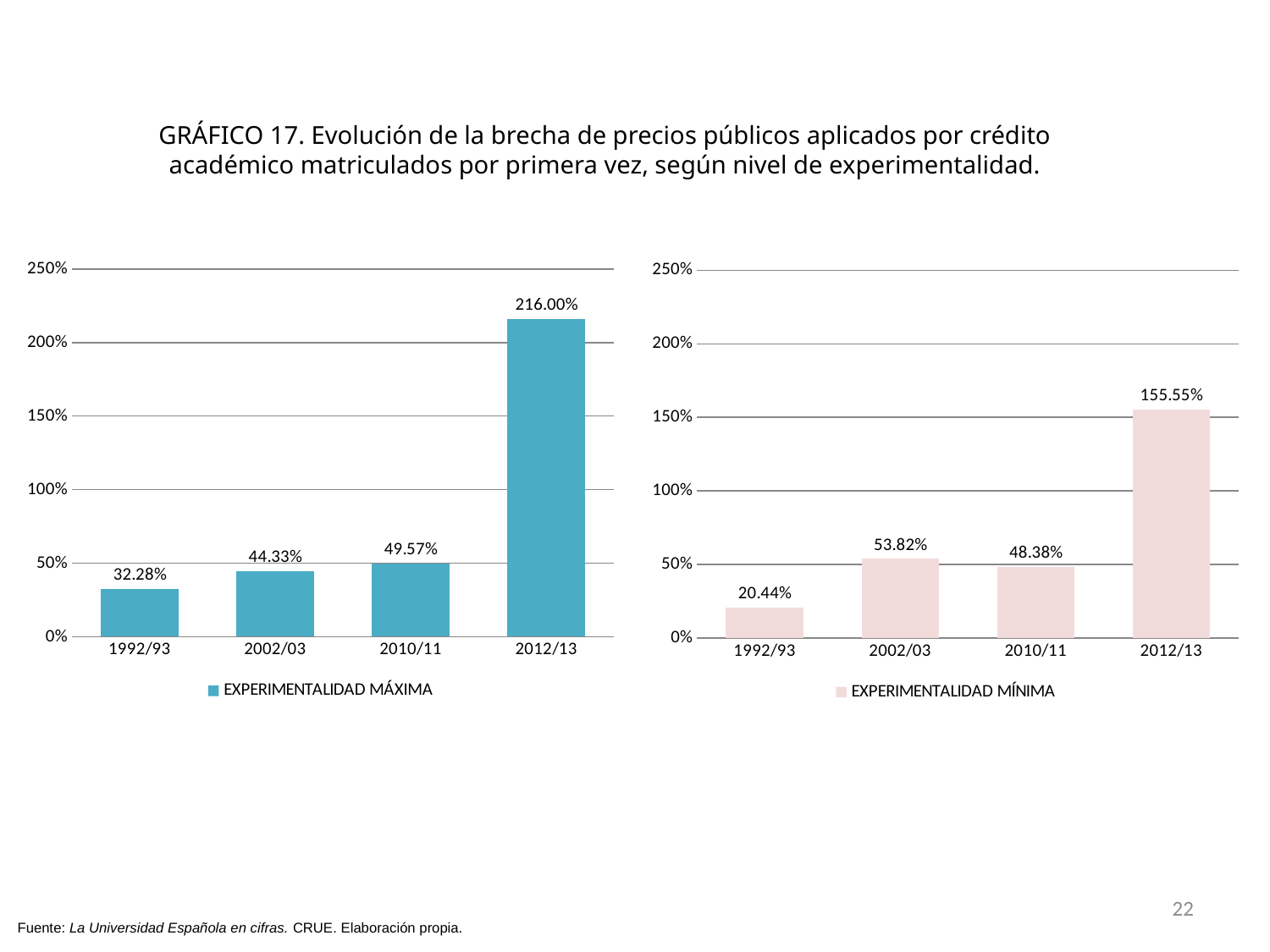
In the right chart (EXPERIMENTALIDAD MÍNIMA), which year has the highest value? 2012/13 In the right chart (EXPERIMENTALIDAD MÍNIMA), what is the value for 1992/93? 20.44% How many years are shown on the x axis of the left chart (EXPERIMENTALIDAD MÁXIMA)? 4 In the right chart (EXPERIMENTALIDAD MÍNIMA), which is larger, the value for 2002/03 or 2010/11? 2002/03 In the left chart (EXPERIMENTALIDAD MÁXIMA), do the values rise or fall from 1992/93 to 2012/13? rise What kind of chart is the right chart (EXPERIMENTALIDAD MÍNIMA)? bar chart In the left chart (EXPERIMENTALIDAD MÁXIMA), what is the value for 2002/03? 44.33% In the right chart (EXPERIMENTALIDAD MÍNIMA), is the value for 2012/13 greater or less than 150%? greater In the left chart (EXPERIMENTALIDAD MÁXIMA), what is the difference between the values for 2012/13 and 2010/11? 166.43% In the left chart (EXPERIMENTALIDAD MÁXIMA), what is the value for 2012/13? 216.00% In the left chart (EXPERIMENTALIDAD MÁXIMA), which year has the lowest value? 1992/93 What series name does the legend of the right chart show? EXPERIMENTALIDAD MÍNIMA